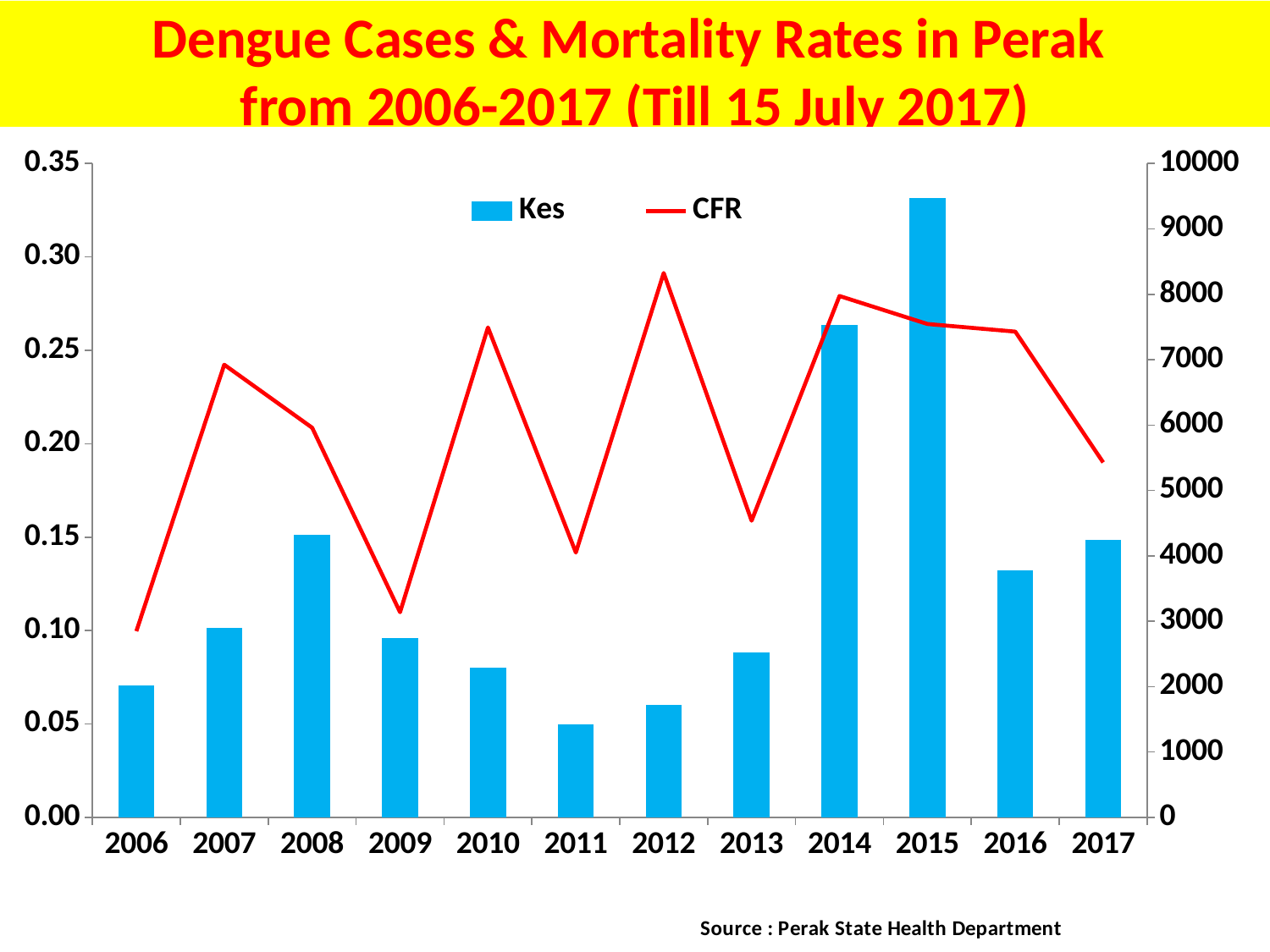
What kind of chart is this? Combination bar and line chart In which year does the CFR line reach its highest point? 2012 Does the CFR line rise or fall from 2014 to 2017? Fall How many years are shown on the x axis? 12 Which year has the lowest Kes bar? 2011 Which year has the larger Kes bar, 2008 or 2016? 2008 Which year has the highest Kes bar? 2015 Is the Kes value for 2015 greater or less than 9000? greater Is the CFR value for 2012 greater or less than 0.25? greater Is the Kes value for 2011 greater or less than 2000? less How many series does the legend list? 2